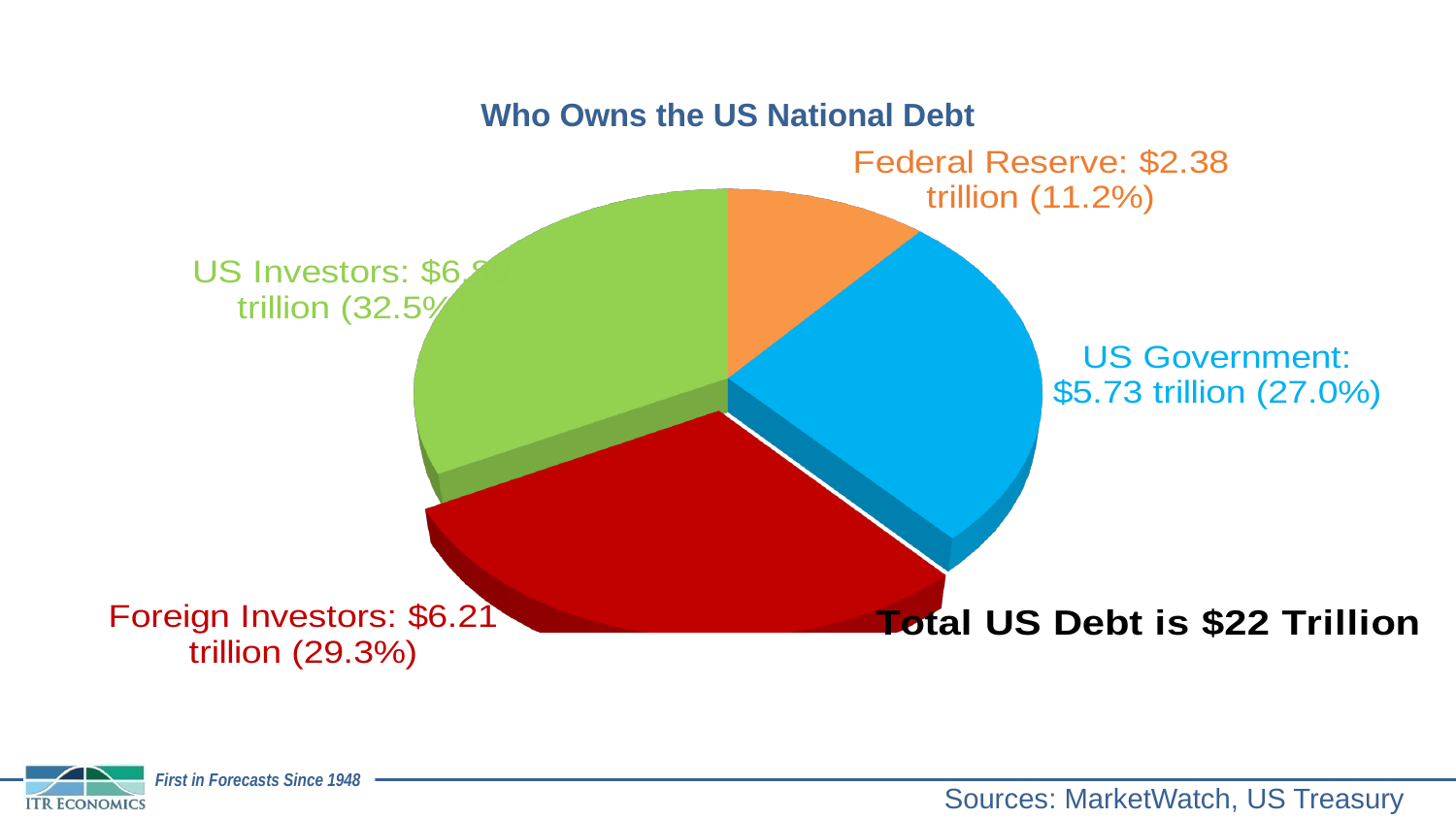
What percentage of the US national debt is held by the US Government? 27.0% What is the difference in dollar value between the Foreign Investors slice and the US Government slice? $0.48 trillion How many slices does the pie chart have? 4 What is the value shown for the US Government slice? $5.73 trillion What is the title of the chart? Who Owns the US National Debt Which owner holds the largest share of the US national debt? US Investors What is the value shown for the Federal Reserve slice? $2.38 trillion Which is larger, the Foreign Investors slice or the US Government slice? Foreign Investors Which owner holds the smallest share of the US national debt? Federal Reserve What share of the pie does the Federal Reserve slice represent? 11.2% What type of chart is shown on the slide? Pie chart What is the value shown for the Foreign Investors slice? $6.21 trillion